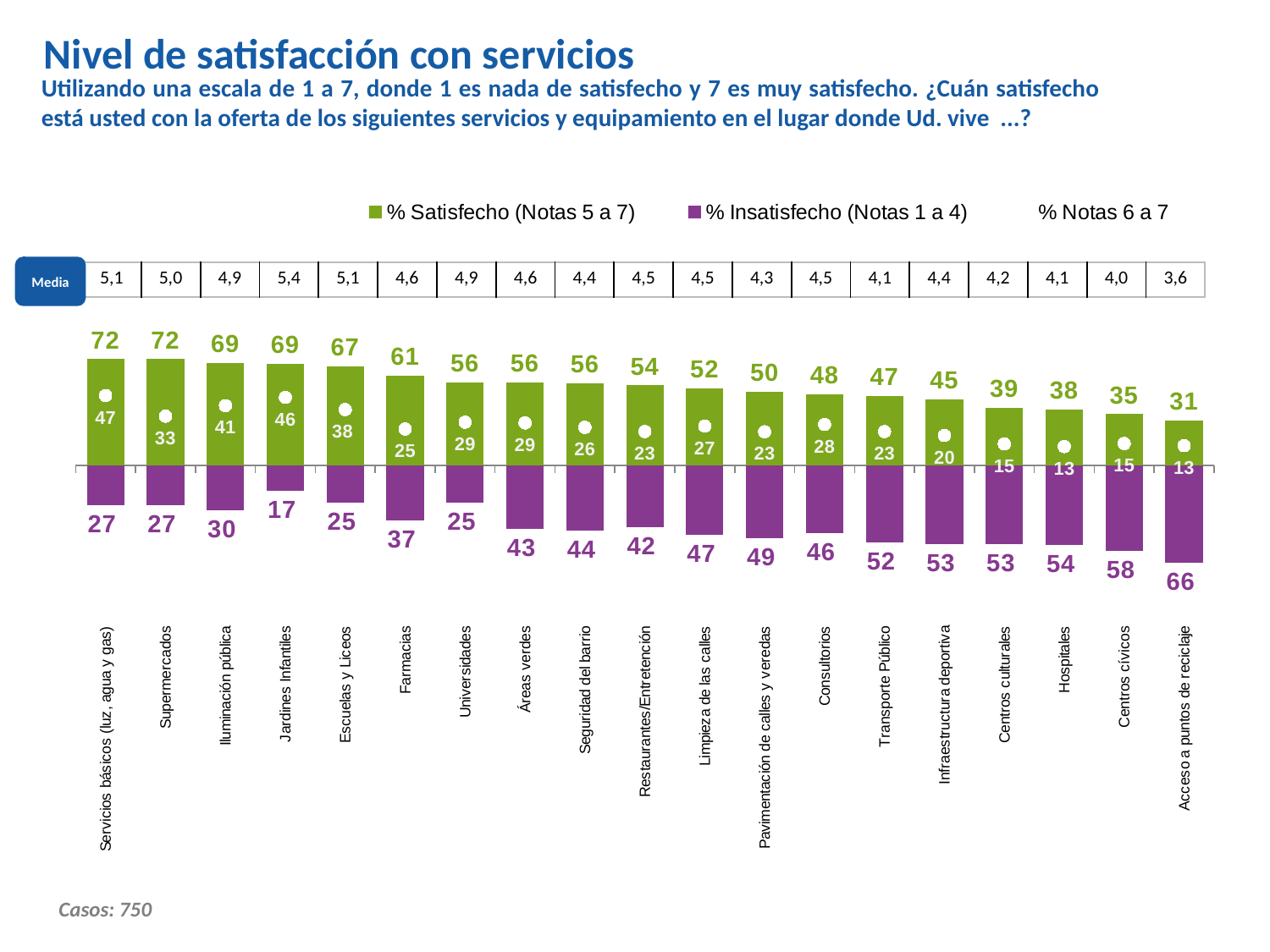
Which category has the highest % Insatisfecho value? Acceso a puntos de reciclaje Which category has the lowest % Satisfecho value? Acceso a puntos de reciclaje What is the difference between the % Satisfecho and % Insatisfecho values for Hospitales? 16 What is the % Insatisfecho value for Jardines Infantiles? 17 What is the % Notas 6 a 7 value for Servicios básicos (luz, agua y gas)? 47 What kind of chart is shown on the slide? Bar chart What is the % Satisfecho value for Farmacias? 61 Do the % Satisfecho values rise or fall from left to right along the x axis? Fall What is the Media value shown for Acceso a puntos de reciclaje? 3,6 How many categories are shown on the x axis of the chart? 19 How many series does the legend list? 3 Which is larger for Transporte Público: % Satisfecho or % Insatisfecho? % Insatisfecho